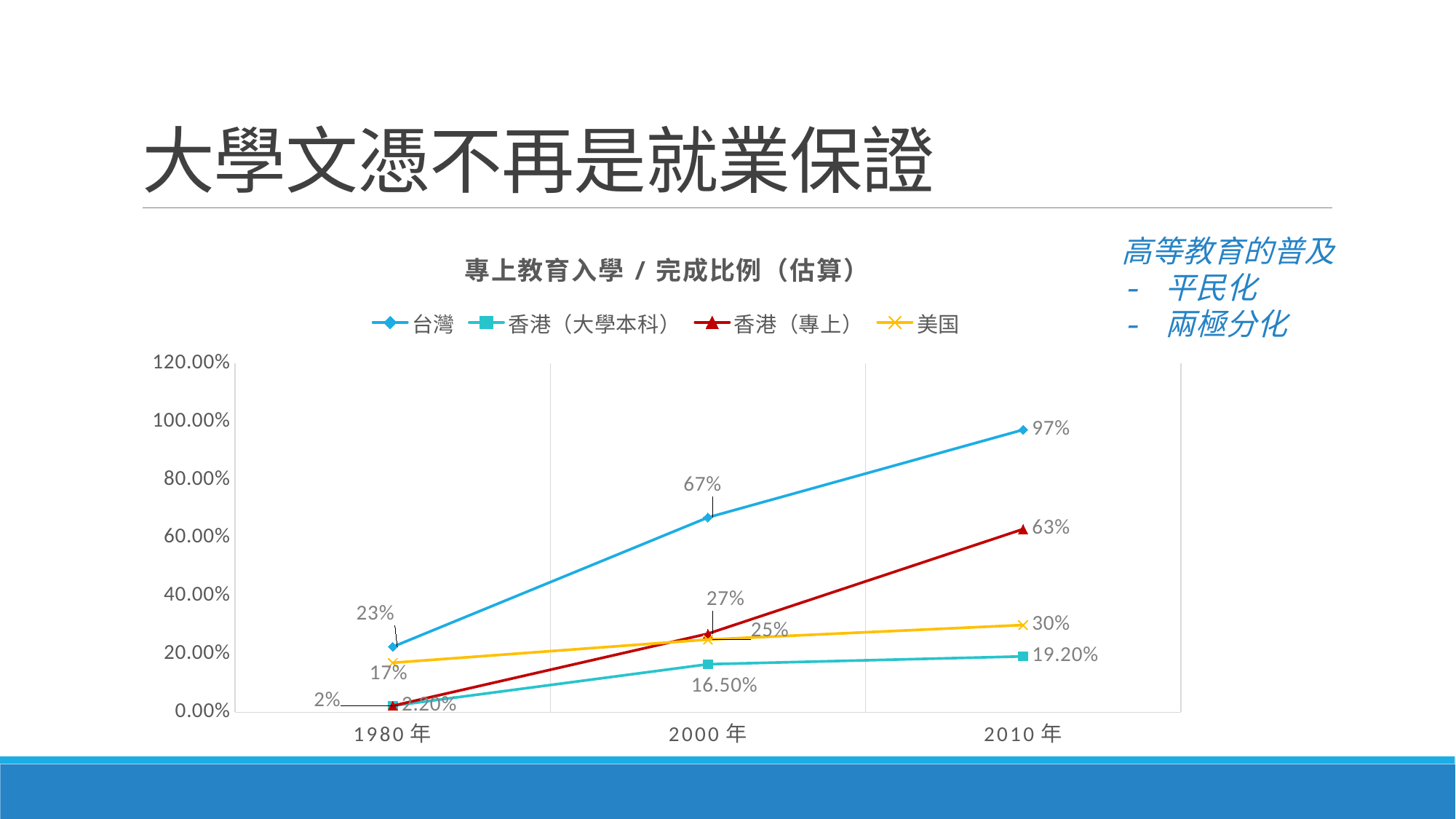
What is the value for 台灣 in 2000 年? 67% Which series has the highest value in 2010 年? 台灣 Does the value for 台灣 rise or fall from 1980 年 to 2010 年? Rise What kind of chart is shown on the slide? Line chart How many years are shown on the x axis of the chart? 3 What is the value for 香港（專上） in 2010 年? 63% What is the value for 香港（大學本科） in 2010 年? 19.20% How many series does the chart legend list? 4 By how much did the value for 台灣 increase from 2000 年 to 2010 年? 30 percentage points What is the value for 美国 in 2010 年? 30% What is the title of the chart? 專上教育入學／完成比例（估算） What is the value for 台灣 in 2010 年? 97%